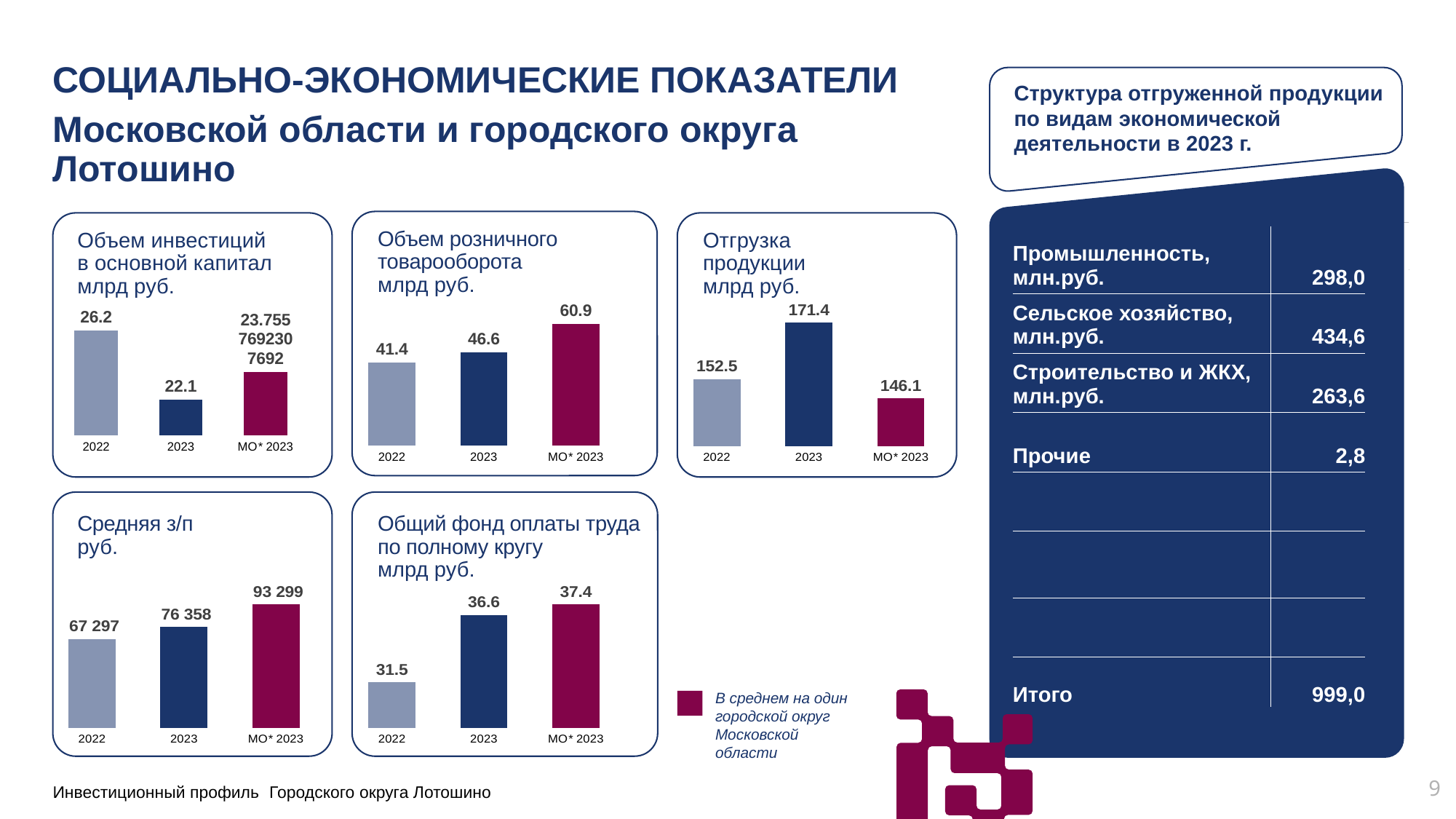
In the chart 'Отгрузка продукции млрд руб.', which is larger, the value for 2022 or the value for МО* 2023? 2022 In the chart 'Общий фонд оплаты труда по полному кругу млрд руб.', what is the value for МО* 2023? 37.4 In the chart 'Отгрузка продукции млрд руб.', what is the value for МО* 2023? 146.1 How many bars are in the chart 'Общий фонд оплаты труда по полному кругу млрд руб.'? 3 In the chart 'Объем розничного товарооборота млрд руб.', what is the value for 2023? 46.6 In the chart 'Средняя з/п руб.', what is the difference between the 2023 value and the 2022 value? 9 061 In the chart 'Объем инвестиций в основной капитал млрд руб.', which category has the lowest value? 2023 What kind of chart is 'Средняя з/п руб.'? Bar chart In the chart 'Средняя з/п руб.', what is the value for 2022? 67 297 In the chart 'Объем розничного товарооборота млрд руб.', do the values rise or fall from 2022 to МО* 2023? Rise In the chart 'Отгрузка продукции млрд руб.', which category has the highest value? 2023 In the chart 'Объем розничного товарооборота млрд руб.', what is the difference between the МО* 2023 value and the 2022 value? 19.5